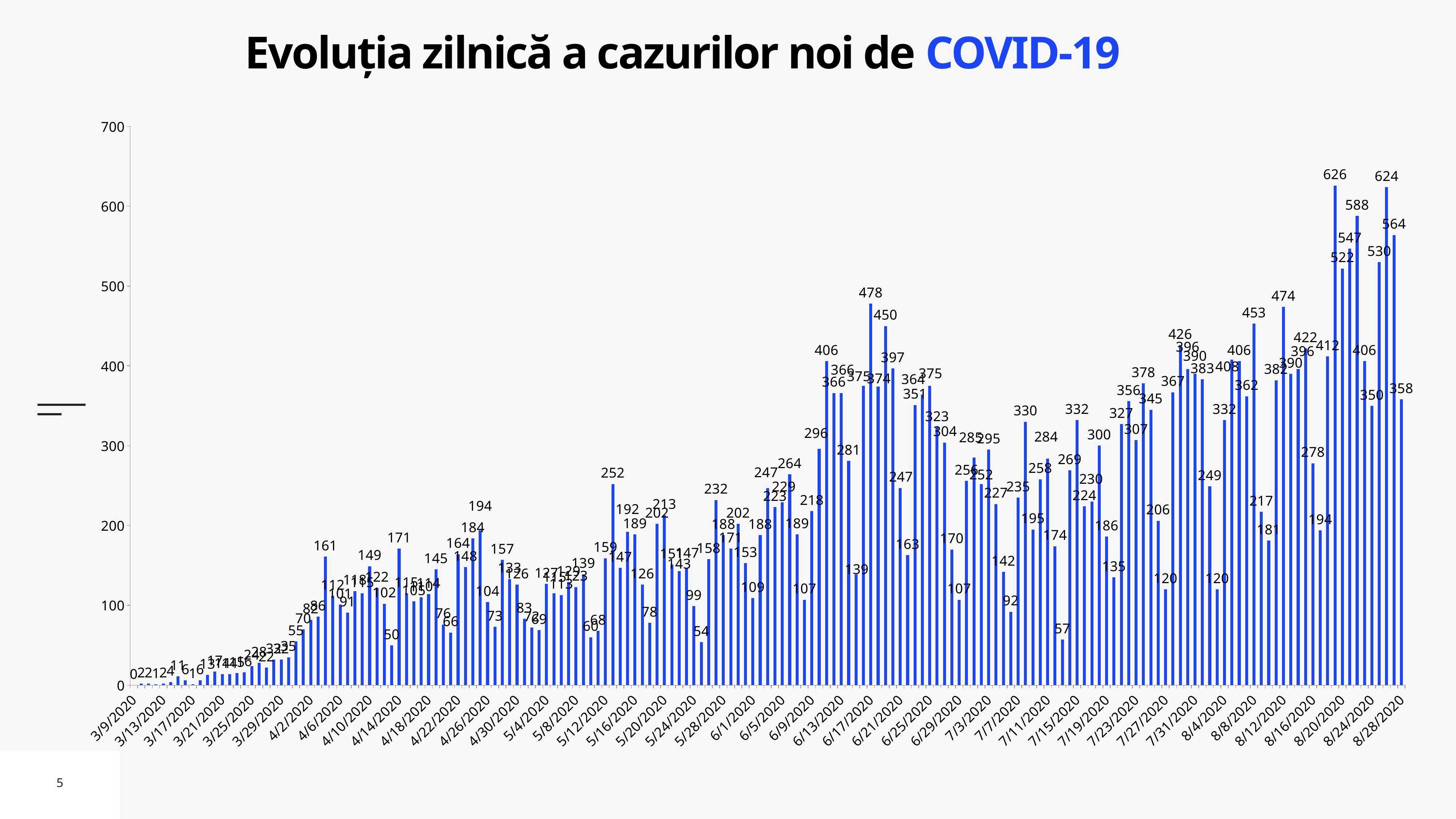
Is the highest value on the chart greater or less than 600? greater What is the second highest daily value shown in the chart? 624 How many data series are plotted in the chart? 1 Is the value for 3/9/2020 greater or less than 100? less What is the maximum value shown on the vertical axis? 700 What kind of chart is shown on the slide? bar chart What is the title of the chart? Evoluția zilnică a cazurilor noi de COVID-19 What is the difference between the two highest values, 626 and 624? 2 Overall, do the daily values rise or fall from March to August 2020? rise What is the highest daily value reached in June 2020? 478 What is the highest daily value shown in the chart? 626 What is the value for 3/9/2020, the first date on the chart? 0